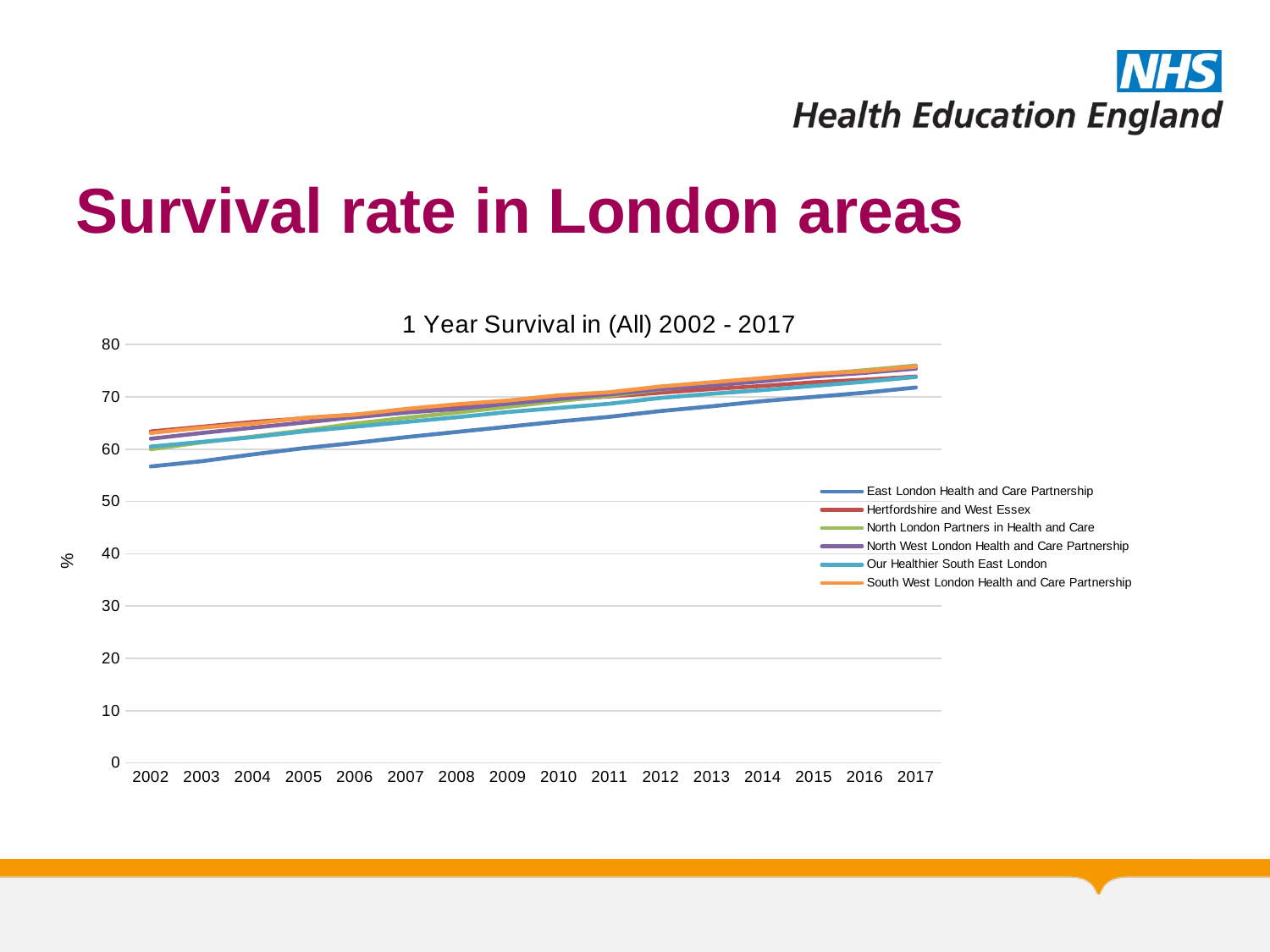
Is the value for East London Health and Care Partnership in 2002 greater or less than 60? less How many series does the legend list? 6 How many years are shown along the x axis? 16 What is the label on the y axis? % Which series has the lowest value in 2017? East London Health and Care Partnership Which series has the lowest value in 2002? East London Health and Care Partnership Do the survival rates rise or fall from 2002 to 2017? rise Is the value for Our Healthier South East London in 2002 greater or less than 50? greater In 2010, which is higher: East London Health and Care Partnership or South West London Health and Care Partnership? South West London Health and Care Partnership What is the title of the chart? 1 Year Survival in (All) 2002 - 2017 What kind of chart is shown on the slide? line chart Is the value for South West London Health and Care Partnership in 2017 greater or less than 70? greater